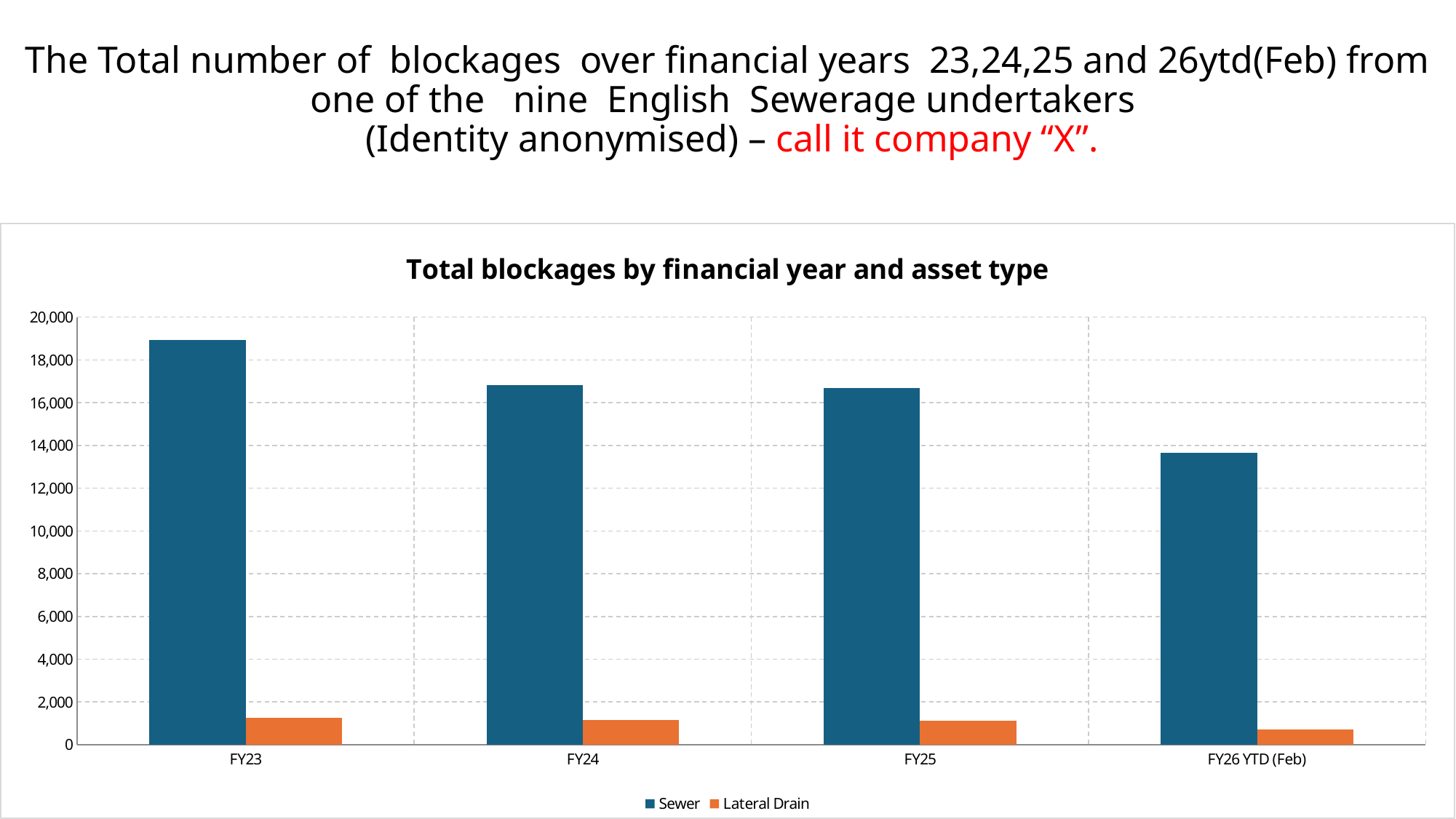
Is the Sewer value for FY23 greater or less than 18,000? greater How many financial year categories are shown on the x axis? 4 What is the title of the chart? Total blockages by financial year and asset type Which is larger in FY24, the Sewer value or the Lateral Drain value? Sewer Which financial year has the lowest Lateral Drain blockages value? FY26 YTD (Feb) Do the Sewer values rise or fall from FY23 to FY26 YTD (Feb)? fall What kind of chart is shown on the slide? bar chart How many series does the legend list? 2 Is the Lateral Drain value for FY23 greater or less than 2,000? less Is the Sewer value for FY26 YTD (Feb) greater or less than 14,000? less Which financial year has the highest Sewer blockages value? FY23 Which financial year has the lowest Sewer blockages value? FY26 YTD (Feb)